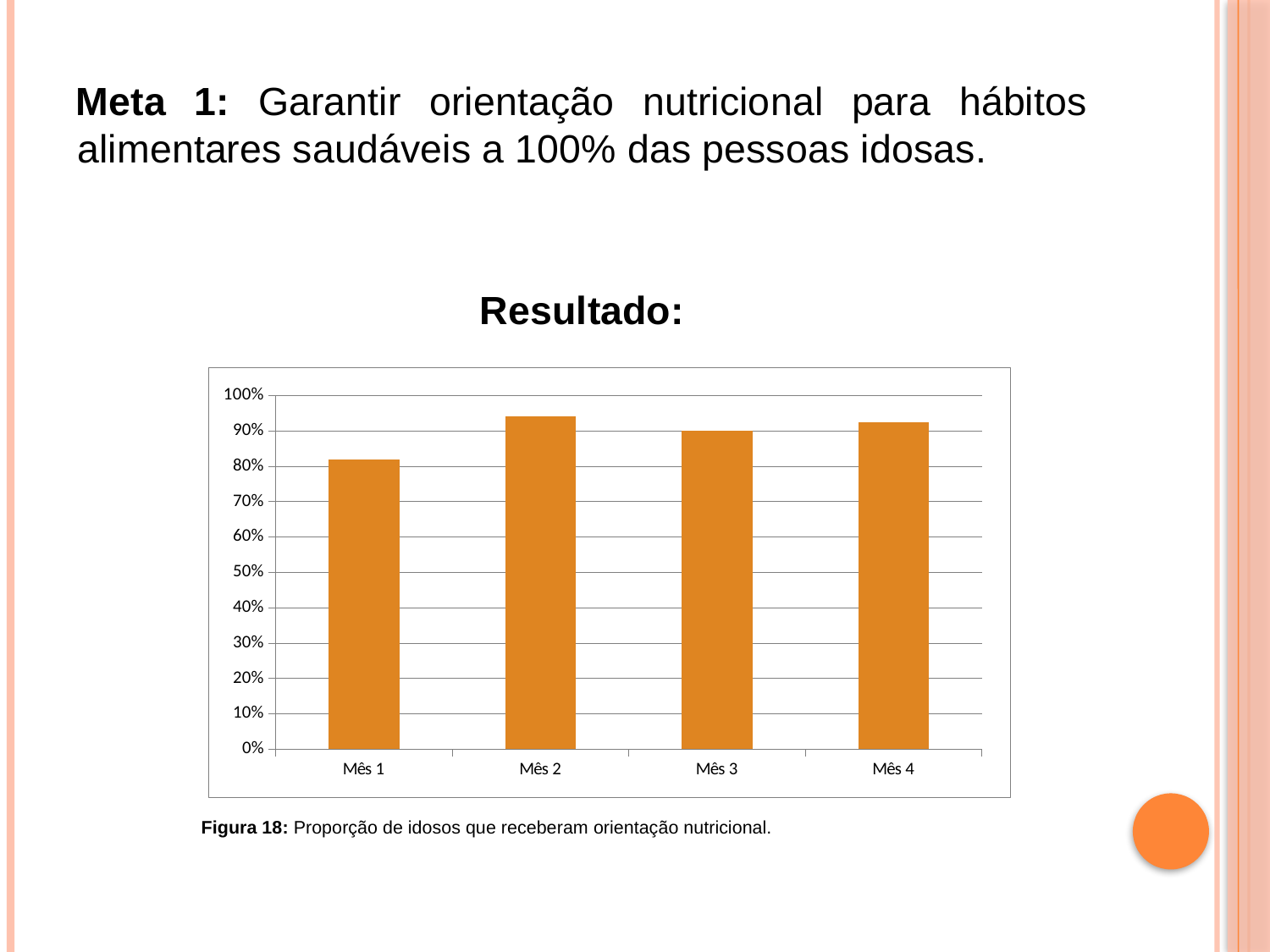
Is the value for Mês 3 greater or less than 80%? greater Which is larger, the value for Mês 1 or the value for Mês 3? Mês 3 Is the value for Mês 2 greater or less than 90%? greater Which month has the lowest value on the chart? Mês 1 What kind of chart is shown on the slide? bar chart How many months (categories) are plotted on the chart? 4 Is the value for Mês 1 greater or less than 90%? less What colour are the bars in the chart? orange What is the figure number given in the caption below the chart? Figura 18 Which is larger, the value for Mês 1 or the value for Mês 2? Mês 2